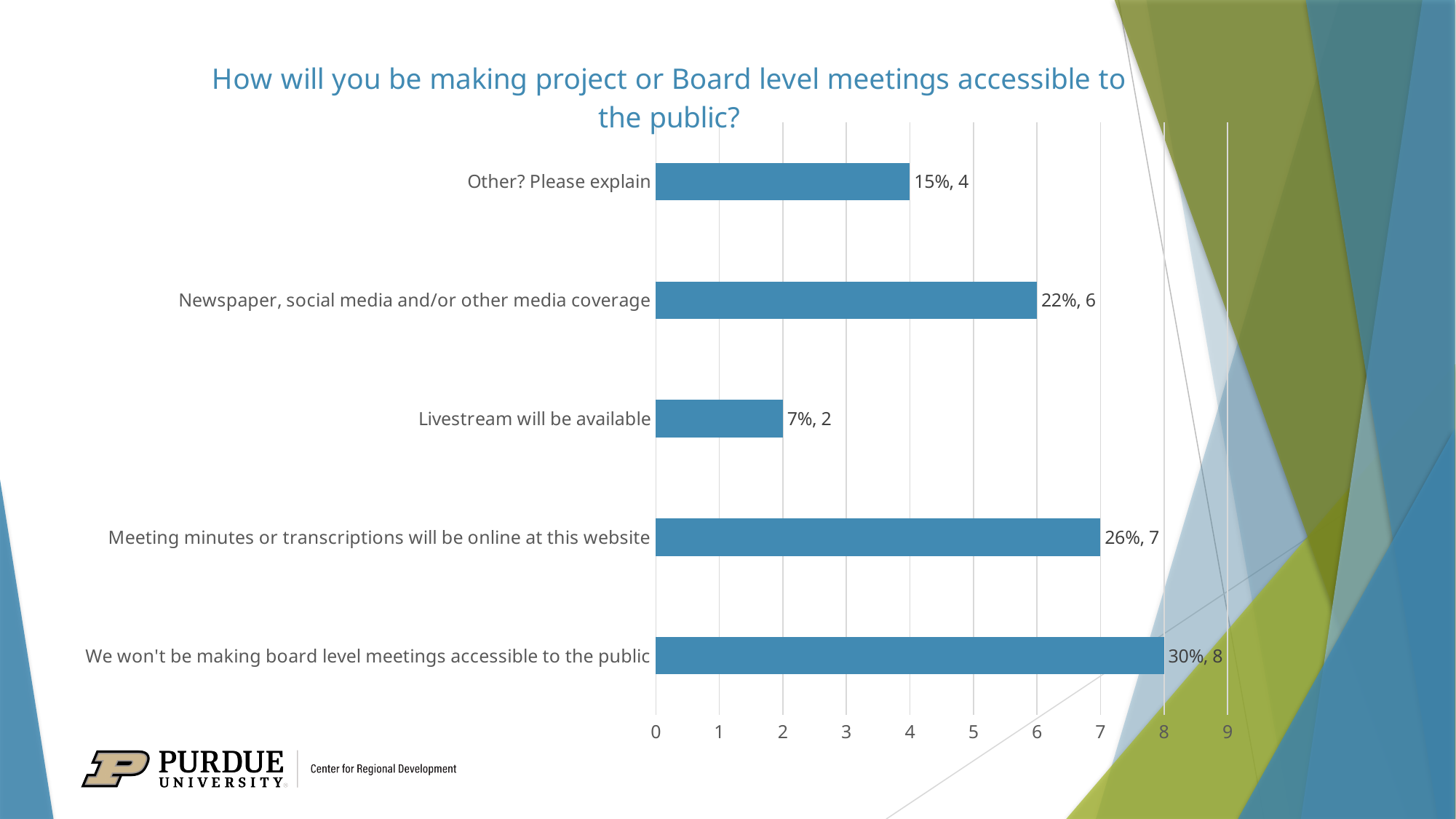
What is the title of the chart? How will you be making project or Board level meetings accessible to the public? How many categories are shown in the chart? 5 What is the difference in count between "Meeting minutes or transcriptions will be online at this website" and "Livestream will be available"? 5 What is the highest value shown on the x axis? 9 Which has a larger count: "Newspaper, social media and/or other media coverage" or "Other? Please explain"? Newspaper, social media and/or other media coverage What is the count for "Other? Please explain"? 4 What is the count for "Livestream will be available"? 2 What kind of chart is shown on the slide? Bar chart What is the data label for "We won't be making board level meetings accessible to the public"? 30%, 8 What percentage is shown for "Newspaper, social media and/or other media coverage"? 22% Which category has the lowest count? Livestream will be available Which category has the highest count? We won't be making board level meetings accessible to the public